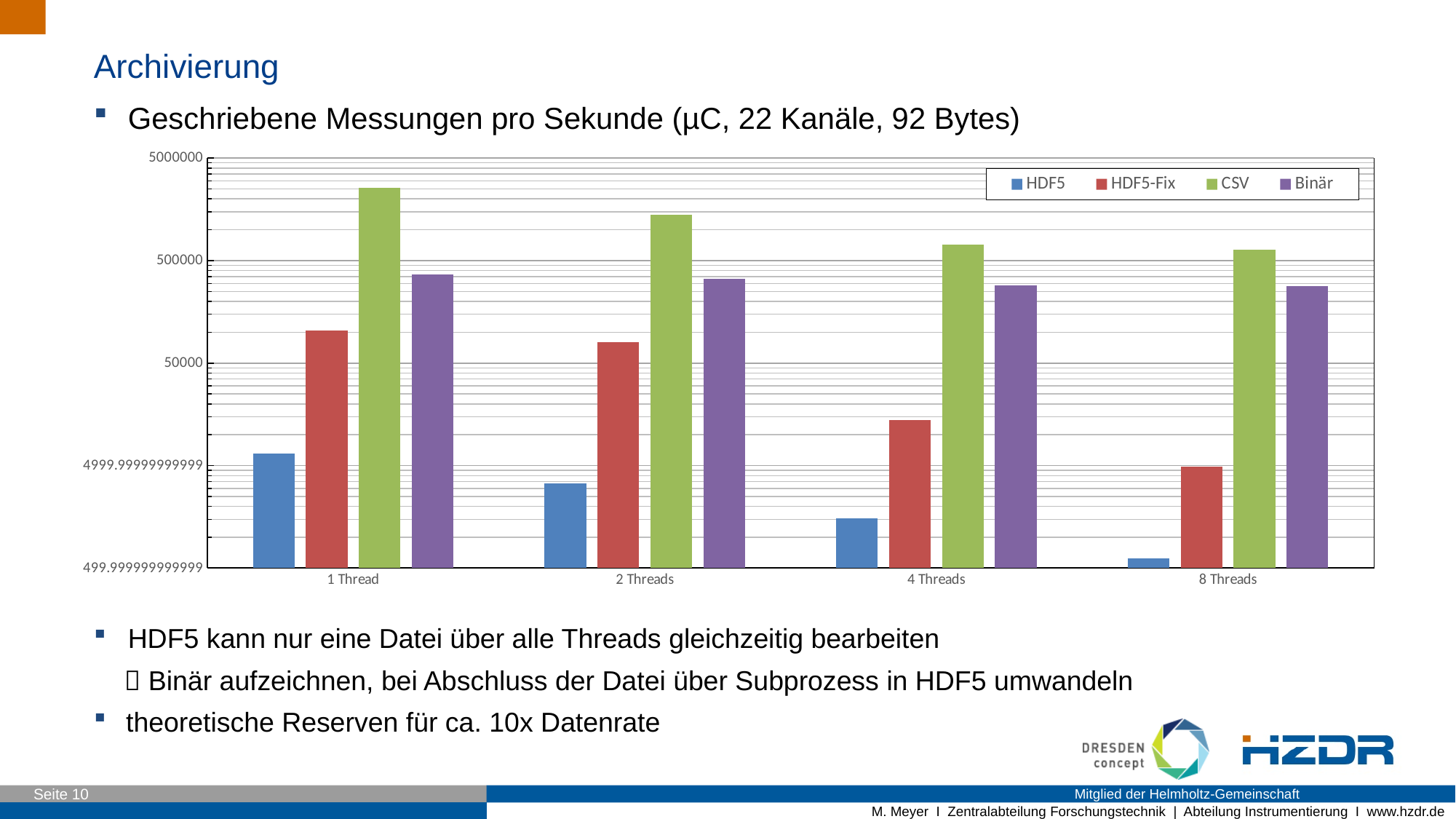
Which series has the highest bar in the 1 Thread category? CSV Do the HDF5 values rise or fall as the number of threads increases from 1 Thread to 8 Threads? fall In the 2 Threads category, which is larger, CSV or Binär? CSV Which series has the lowest bar in the 8 Threads category? HDF5 Is the value for HDF5-Fix at 4 Threads greater or less than 50000? less Is the value for Binär at 4 Threads greater or less than 500000? less In the 4 Threads category, which is larger, HDF5 or HDF5-Fix? HDF5-Fix How many series does the chart's legend list? 4 What kind of chart is shown on the slide? bar chart Is the value for CSV at 1 Thread greater or less than 500000? greater Which colour represents the CSV series in the chart? green How many thread categories are shown on the x axis of the chart? 4